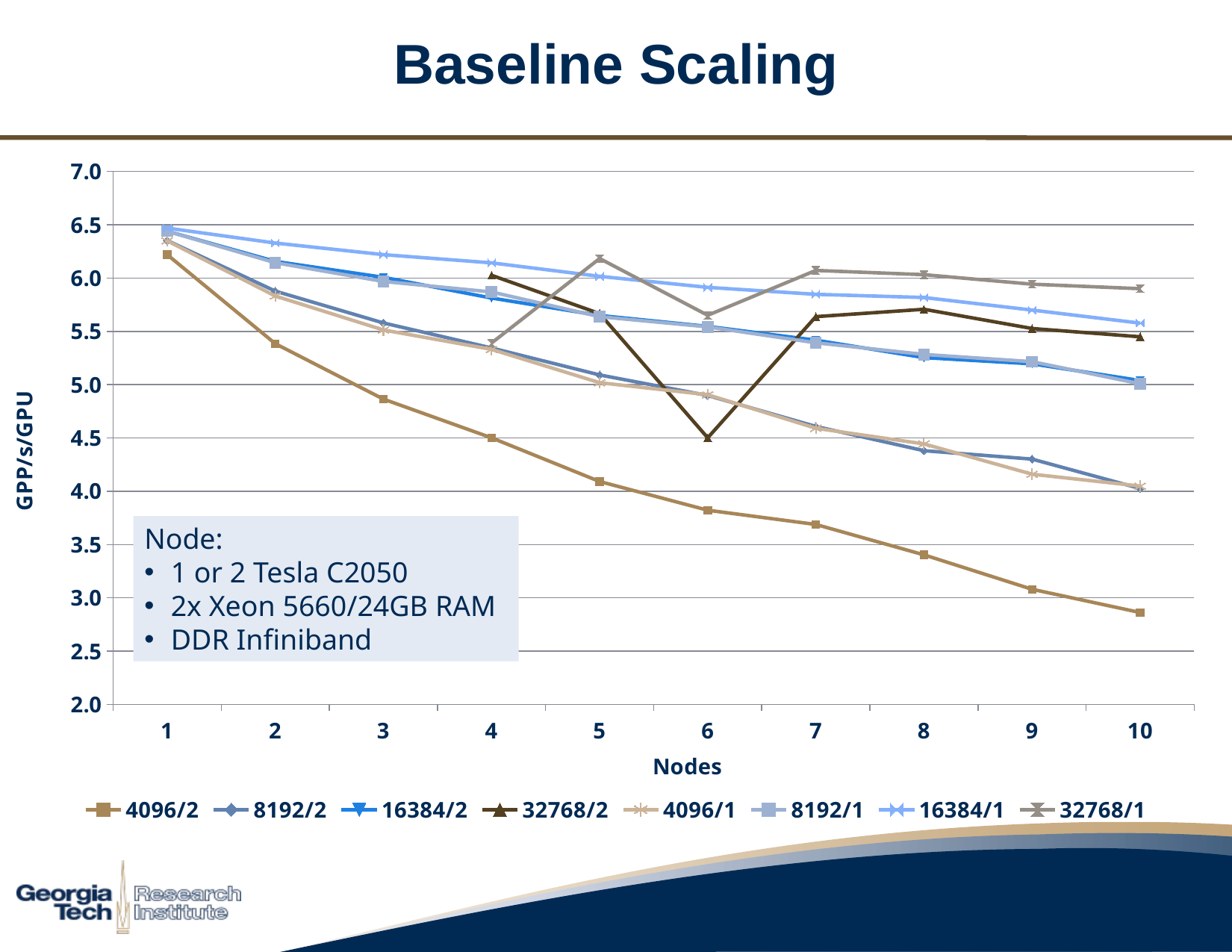
Which series has the highest value at 10 nodes? 32768/1 What is the label of the y axis? GPP/s/GPU Does the 4096/2 series rise or fall as the number of nodes increases? falls Which series has the lowest value at 10 nodes? 4096/2 Is the value for 4096/2 at 1 node greater or less than 6.0? greater At 10 nodes, which is larger: the value for 32768/2 or the value for 8192/1? 32768/2 Is the value for 4096/2 at 10 nodes greater or less than 3.0? less What is the label of the x axis? Nodes What kind of chart is shown on the slide? line chart How many node counts are plotted along the x axis? 10 Is the value for 32768/1 at 5 nodes greater or less than 6.0? greater How many series does the legend list? 8